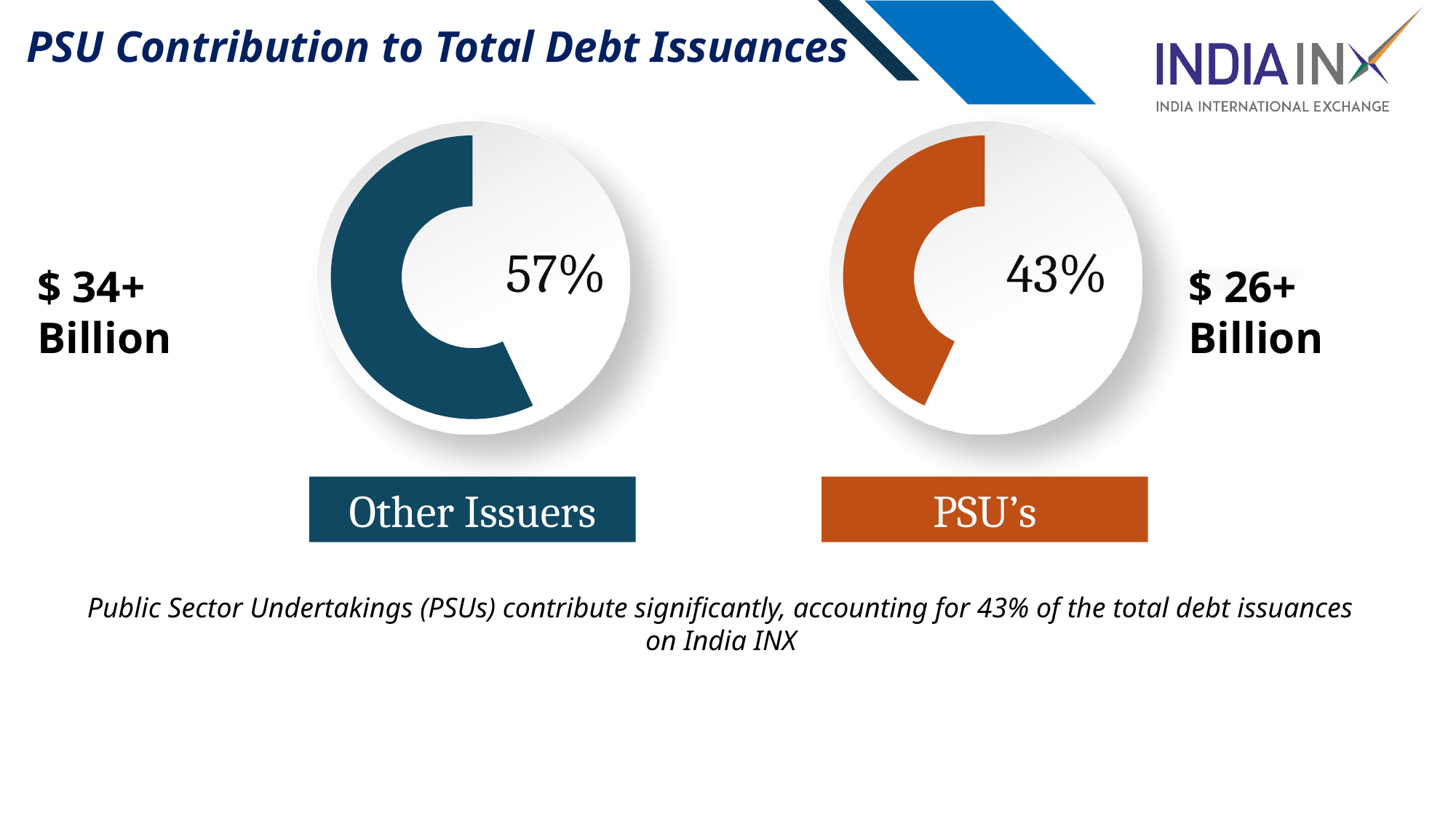
What is the title of the slide? PSU Contribution to Total Debt Issuances What colour is the ring of the PSU's donut chart? Orange What percentage is shown in the right donut chart labelled PSU's? 43% What percentage is shown in the left donut chart labelled Other Issuers? 57% What dollar amount is shown next to the PSU's chart? $ 26+ Billion What is the difference in percentage points between the Other Issuers share and the PSU's share? 14 How many donut charts are on the slide? 2 Which group has the larger share of total debt issuances, Other Issuers or PSU's? Other Issuers What kind of chart is used to show the Other Issuers share? Donut chart What dollar amount is shown next to the Other Issuers chart? $ 34+ Billion Is the PSU's share greater or less than 50%? less Which group has the smaller share of total debt issuances? PSU's